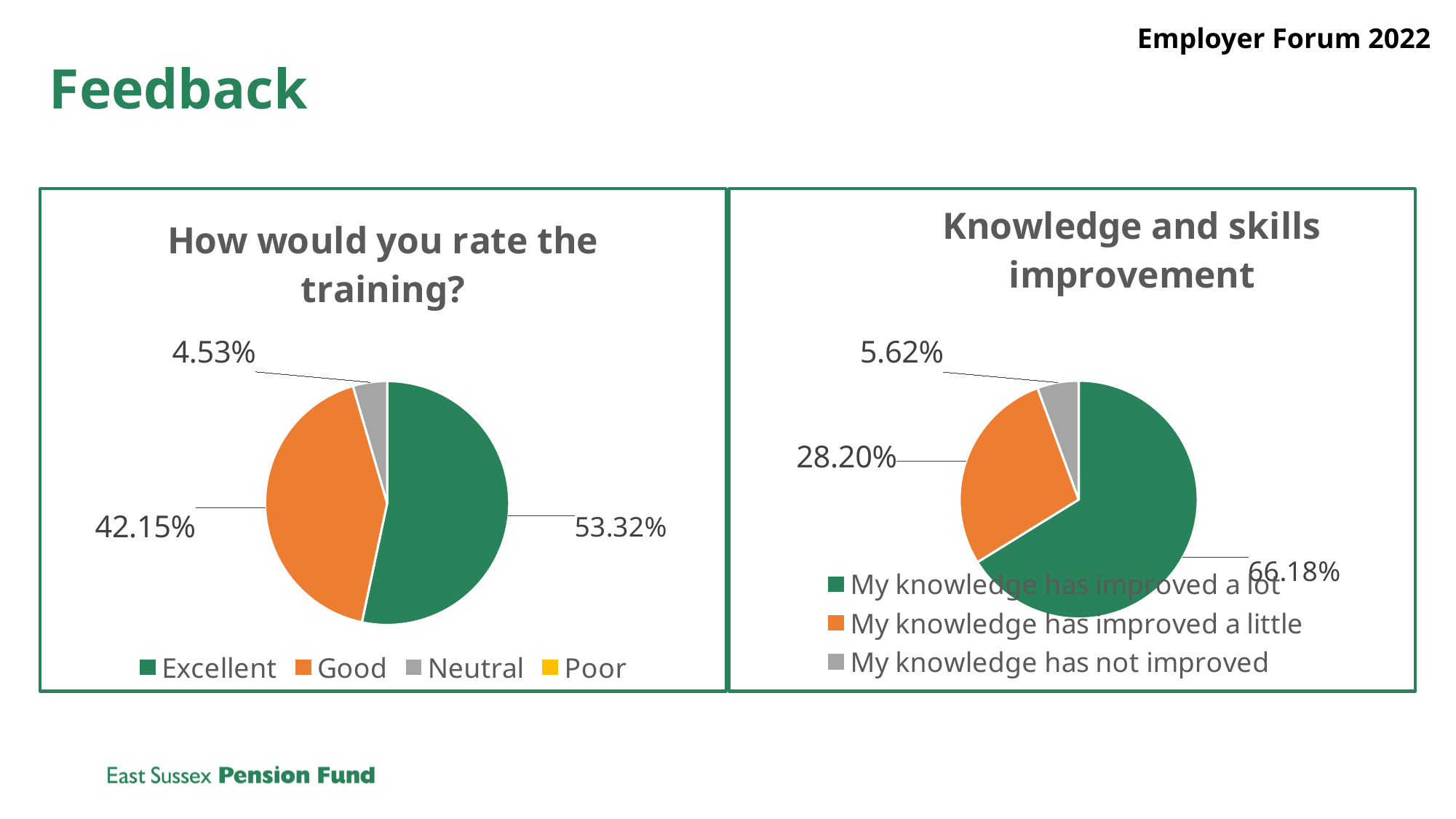
In the 'How would you rate the training?' chart, what share of respondents rated the training Good? 42.15% In the 'Knowledge and skills improvement' chart, which response has the smallest slice? My knowledge has not improved In the 'How would you rate the training?' chart, what share of respondents gave a Neutral rating? 4.53% In the 'Knowledge and skills improvement' chart, what share said their knowledge has not improved? 5.62% In the 'Knowledge and skills improvement' chart, what share said their knowledge has improved a lot? 66.18% In the 'Knowledge and skills improvement' chart, what share said their knowledge has improved a little? 28.20% In the 'How would you rate the training?' chart, which rating has the largest slice? Excellent In the 'How would you rate the training?' chart, what is the difference between the Excellent and Good shares? 11.17% In the 'How would you rate the training?' chart, how many categories does the legend list? 4 In the 'How would you rate the training?' chart, what share of respondents rated the training Excellent? 53.32% What kind of chart is the 'How would you rate the training?' chart? Pie chart In the 'Knowledge and skills improvement' chart, which colour represents 'My knowledge has improved a little'? Orange